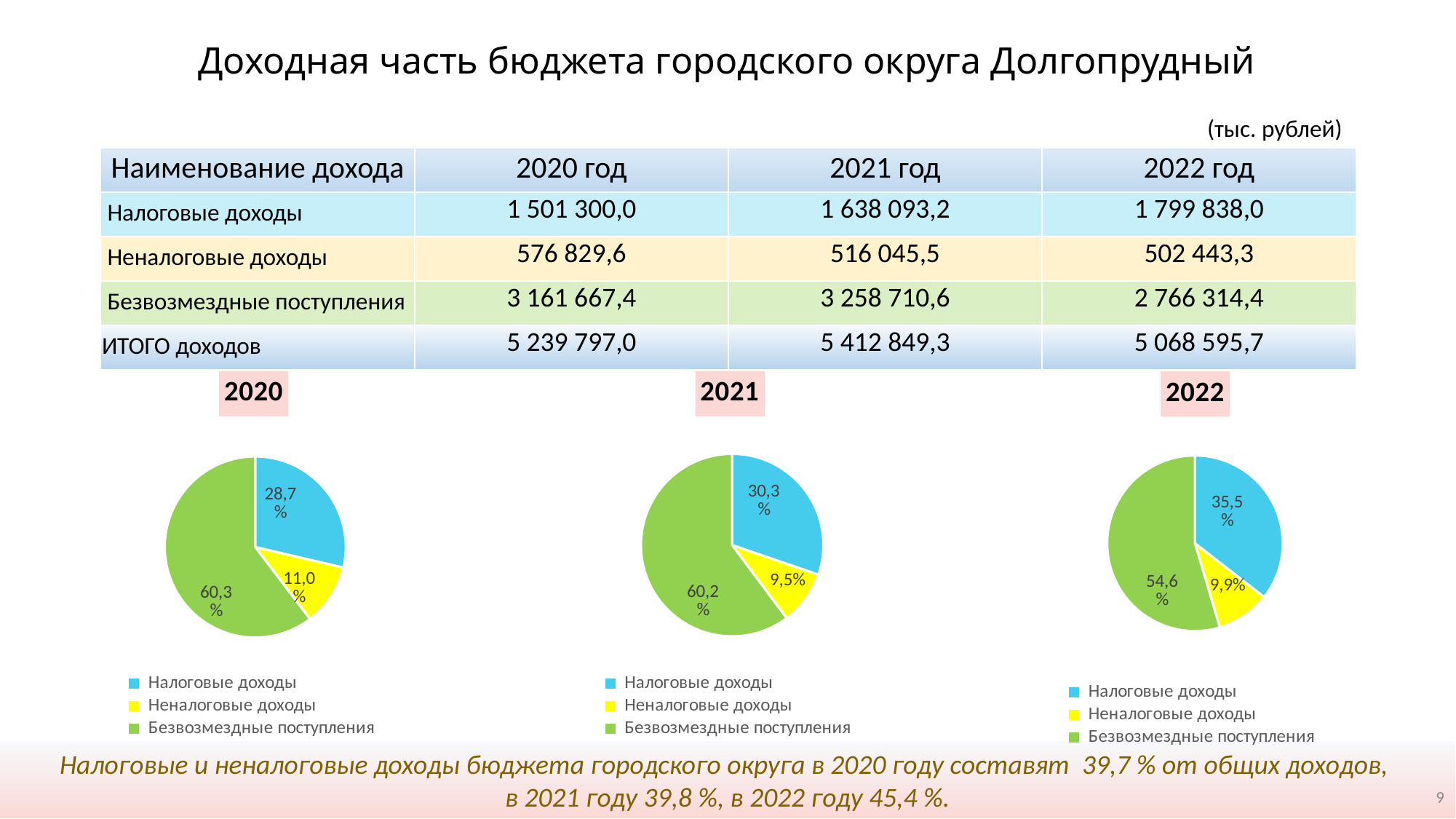
In the 2021 pie chart, what is the difference between the shares of Безвозмездные поступления and Налоговые доходы? 29,9% Is the share of Налоговые доходы larger in the 2020 pie chart or in the 2022 pie chart? 2022 In the 2022 pie chart, which category has the largest share? Безвозмездные поступления In the 2020 pie chart, which category has the smallest share? Неналоговые доходы In the 2020 pie chart, what share is shown for Налоговые доходы? 28,7% How many pie charts are shown on the slide? 3 In the 2022 pie chart, what colour is the slice for Неналоговые доходы? yellow How many slices does the 2021 pie chart have? 3 How many entries does the legend of the 2020 pie chart list? 3 What type of chart is used to show the 2020 revenue structure? pie chart In the 2021 pie chart, what share is shown for Неналоговые доходы? 9,5% In the 2022 pie chart, what share is shown for Безвозмездные поступления? 54,6%